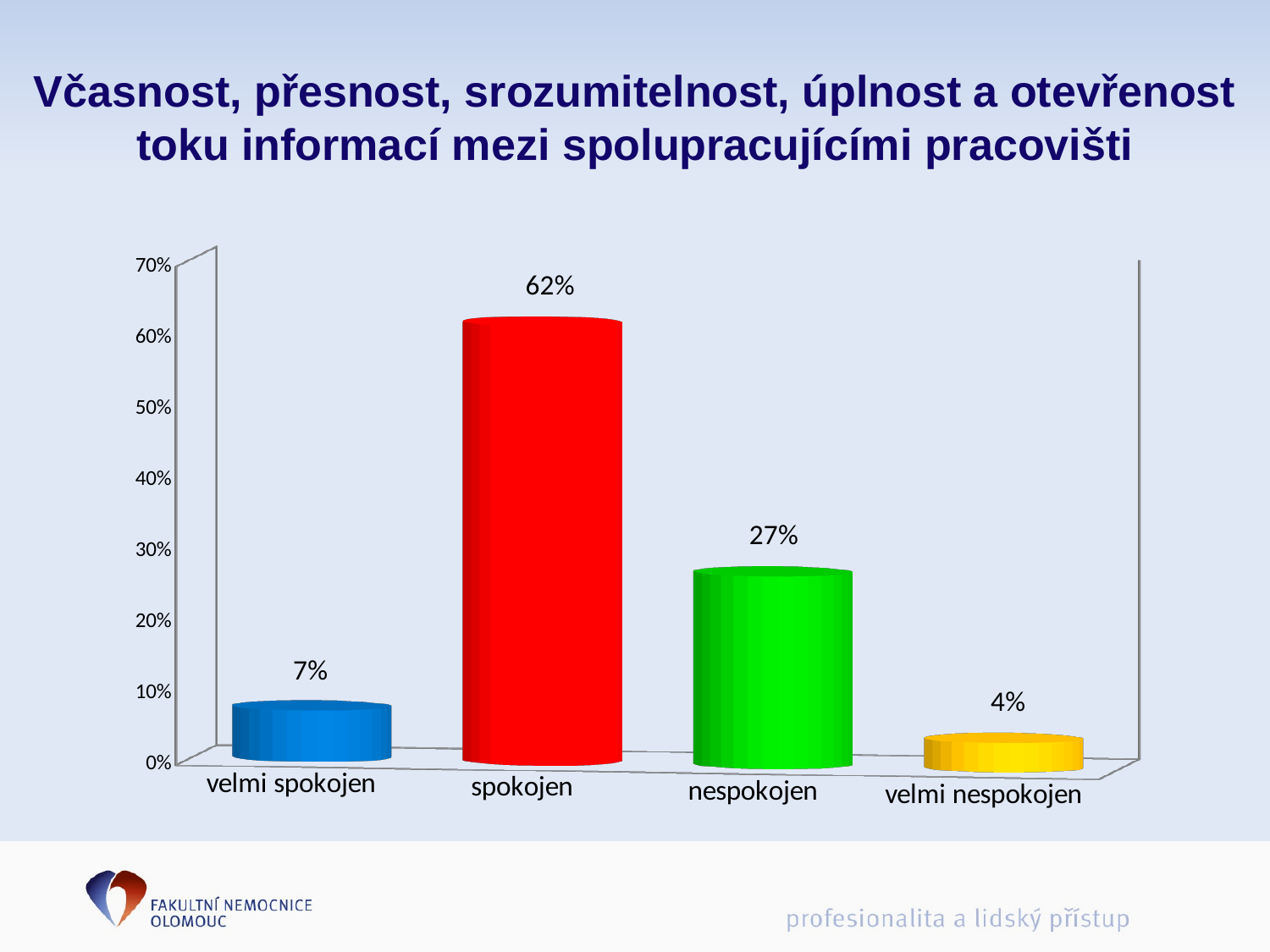
What is the value for "velmi spokojen"? 7% Which is larger, the value for "nespokojen" or the value for "velmi spokojen"? nespokojen How many categories are shown on the x axis? 4 What is the value for "nespokojen"? 27% What is the difference between the values for "spokojen" and "nespokojen"? 35% What is the difference between the values for "velmi spokojen" and "velmi nespokojen"? 3% What kind of chart is shown on the slide? bar chart Is the value for "spokojen" greater or less than 50%? greater What is the value for "velmi nespokojen"? 4% What is the value for "spokojen"? 62% Which category has the lowest value? velmi nespokojen Which category has the highest value? spokojen